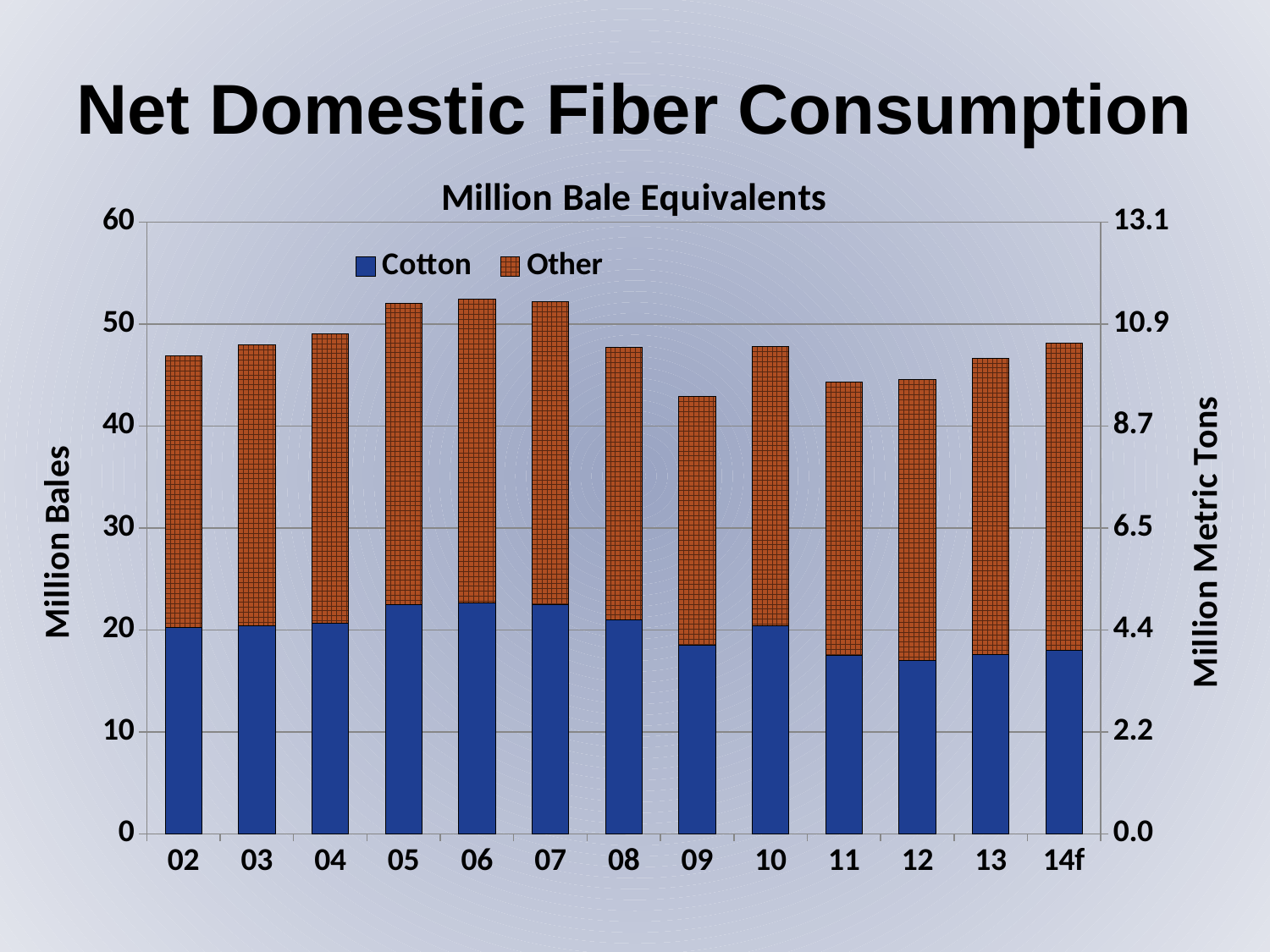
Is the Cotton value for 05 greater or less than 20 million bales? greater How many years (categories) are shown on the x axis? 13 What is the label on the right-hand vertical axis? Million Metric Tons What kind of chart is shown on the slide? Stacked bar chart Is the Cotton value for 12 greater or less than 20 million bales? less How many series does the legend list? 2 Which year has the larger Cotton value, 06 or 12? 06 Is the total bar for 06 greater or less than 50 million bales? greater Do the total bars rise or fall from 02 to 06? rise Which year has the larger total bar, 05 or 09? 05 Which year has the lowest total fiber consumption? 09